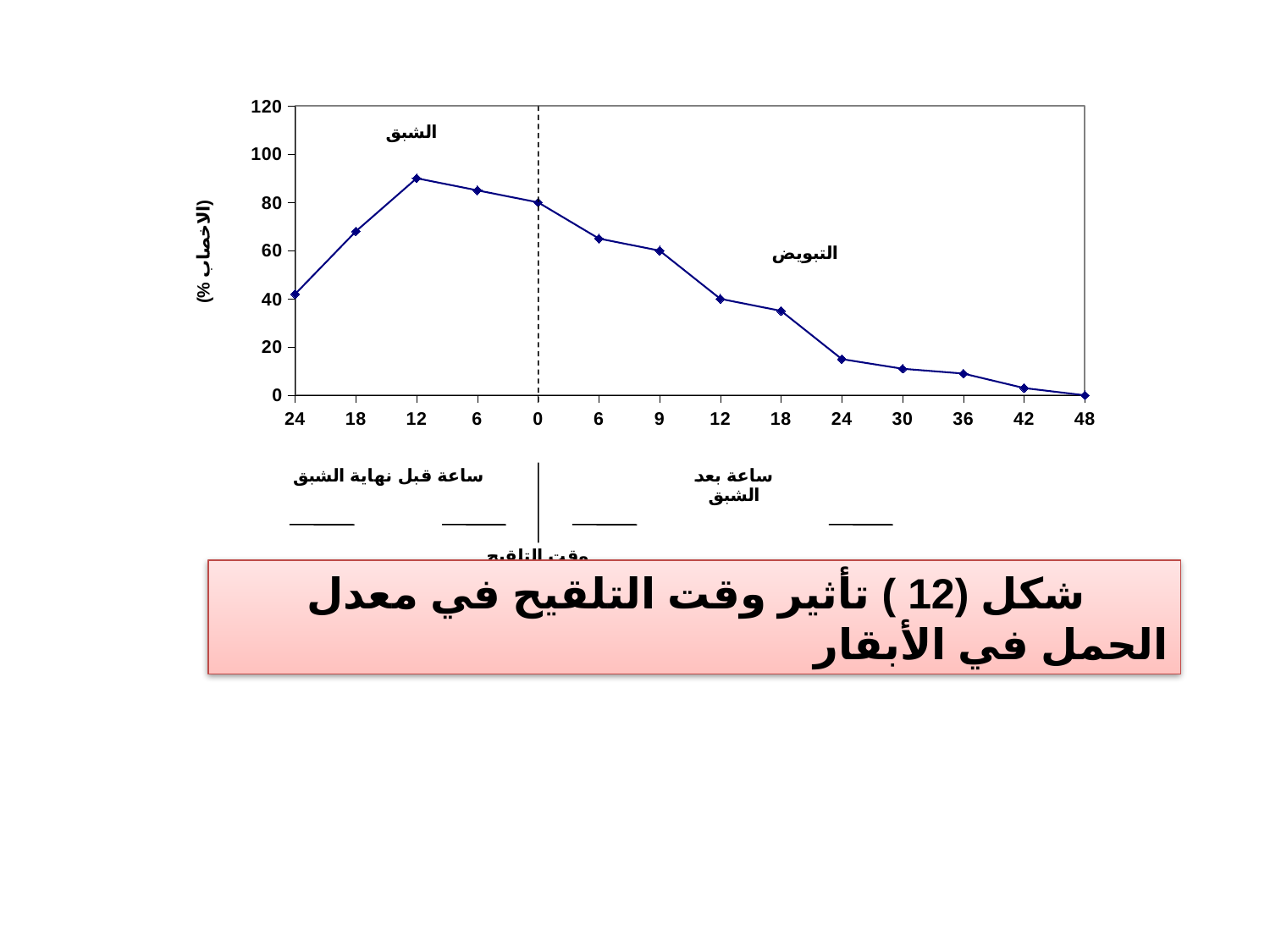
What is the label of the y axis? الاخصاب (%) What is the highest value shown on the y axis? 120 What kind of chart is shown on the slide? line chart At which x-axis position does the line reach its lowest value? 48 (hours after estrus) Which is larger, the value at 6 hours before the end of estrus or the value at 6 hours after estrus? 6 hours before the end of estrus Is the value at 12 hours before the end of estrus greater or less than 80? greater At which x-axis position does the line reach its highest value? 12 (hours before the end of estrus) How many data points are plotted on the line? 14 Do the values rise or fall along the x axis after the insemination time (0)? fall Is the value at 24 hours before the end of estrus greater or less than 60? less Is the value at 6 hours after estrus greater or less than 60? greater